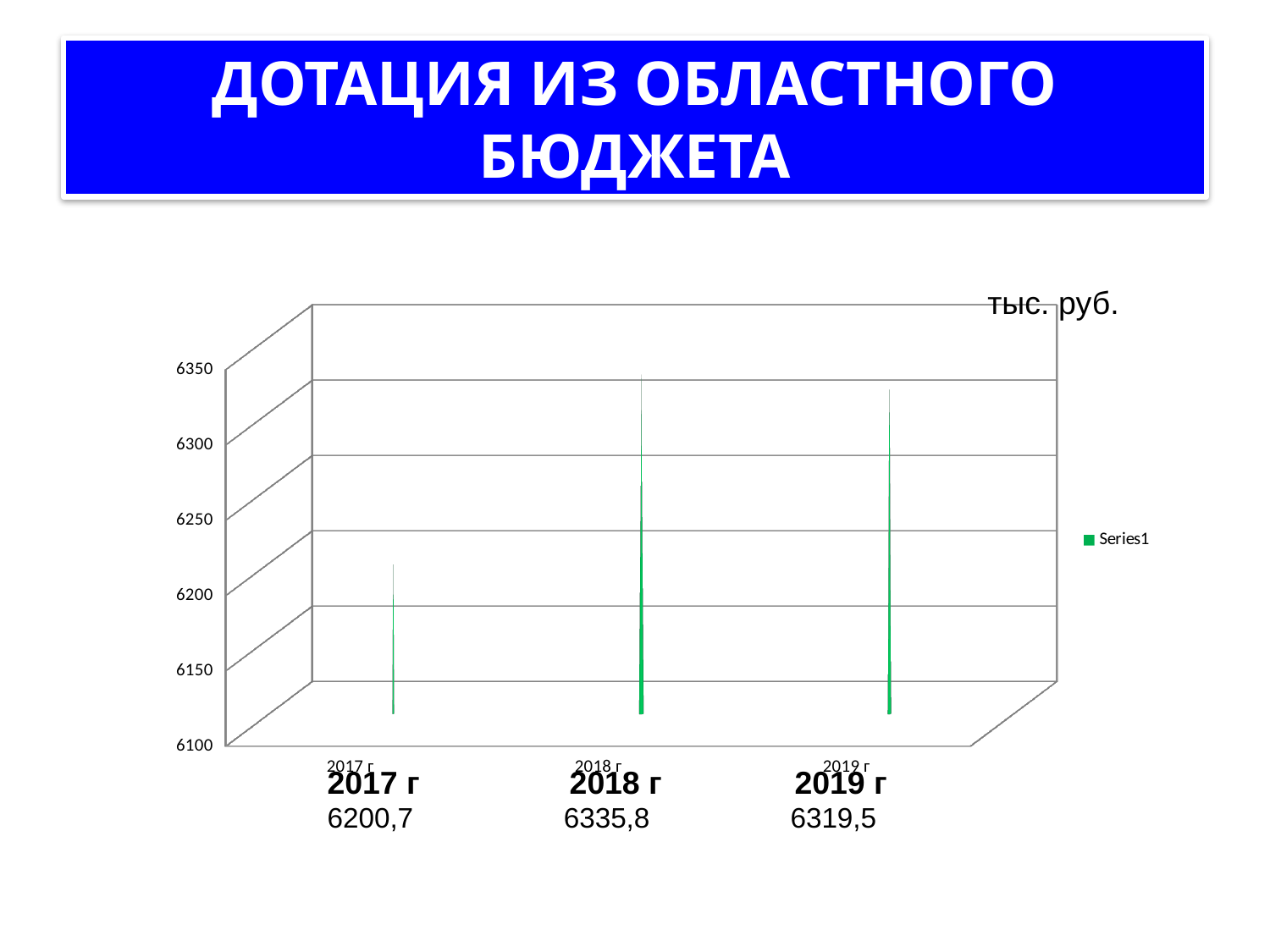
Which year has the lowest value? 2017 г What is the value for 2019 г? 6319,5 How many series does the legend list? 1 What kind of chart is shown on the slide? bar chart What is the difference between the values for 2018 г and 2019 г? 16,3 What is the value for 2018 г? 6335,8 Which year has the highest value? 2018 г How many years are shown on the chart? 3 Which is larger, the value for 2019 г or the value for 2017 г? 2019 г What is the value for 2017 г? 6200,7 What is the difference between the values for 2018 г and 2017 г? 135,1 Is the value for 2017 г greater or less than 6250? less